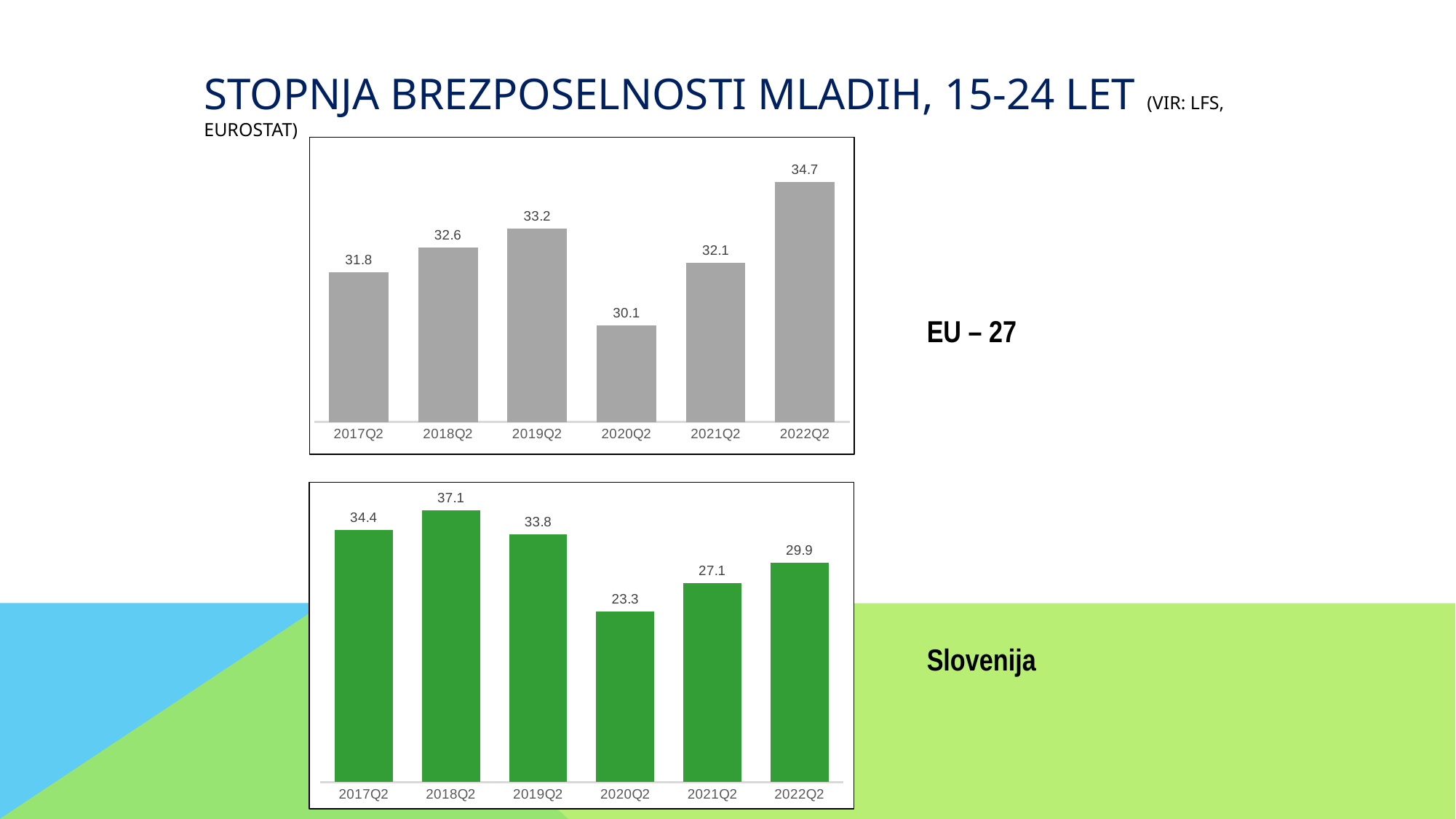
How many quarters are shown in the top chart (EU – 27)? 6 In the bottom chart (Slovenija), which quarter has the lowest value? 2020Q2 In the bottom chart (Slovenija), which is larger, the value for 2017Q2 or the value for 2022Q2? 2017Q2 In the bottom chart (Slovenija), what is the difference between the values for 2018Q2 and 2020Q2? 13.8 In the top chart (EU – 27), what is the value for 2020Q2? 30.1 In the top chart (EU – 27), which quarter has the highest value? 2022Q2 In the bottom chart (Slovenija), what is the value for 2018Q2? 37.1 In the bottom chart (Slovenija), do the values rise or fall from 2020Q2 to 2022Q2? rise What colour are the bars in the bottom chart (Slovenija)? green In the top chart (EU – 27), which is larger, the value for 2019Q2 or the value for 2021Q2? 2019Q2 In the top chart (EU – 27), what is the difference between the values for 2022Q2 and 2021Q2? 2.6 What kind of chart is the bottom chart (Slovenija)? bar chart